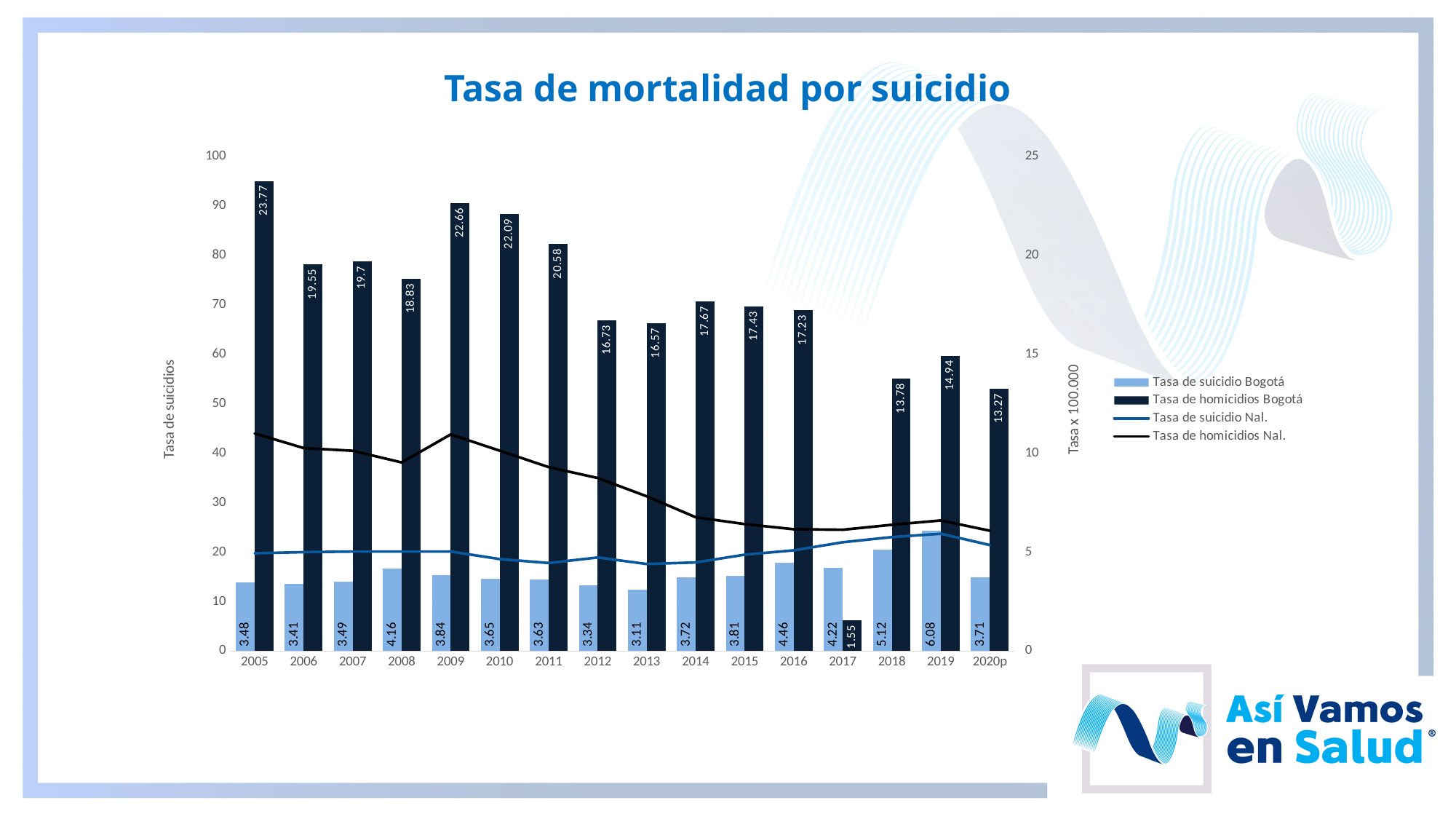
What is the difference between Tasa de homicidios Bogotá in 2005 and in 2020p? 10.5 Does Tasa de homicidios Bogotá generally rise or fall from 2005 to 2020p? Fall How many series does the legend list? 4 In which year is Tasa de suicidio Bogotá lowest? 2013 What is the value of Tasa de suicidio Bogotá for 2019? 6.08 What is the value of Tasa de homicidios Bogotá for 2005? 23.77 Which year has a higher Tasa de suicidio Bogotá, 2017 or 2018? 2018 What is the value of Tasa de homicidios Bogotá for 2009? 22.66 In which year is Tasa de suicidio Bogotá highest? 2019 How many years are shown on the x axis? 16 What is the difference between Tasa de suicidio Bogotá in 2019 and in 2018? 0.96 What kind of chart is shown on the slide? Combined bar and line chart